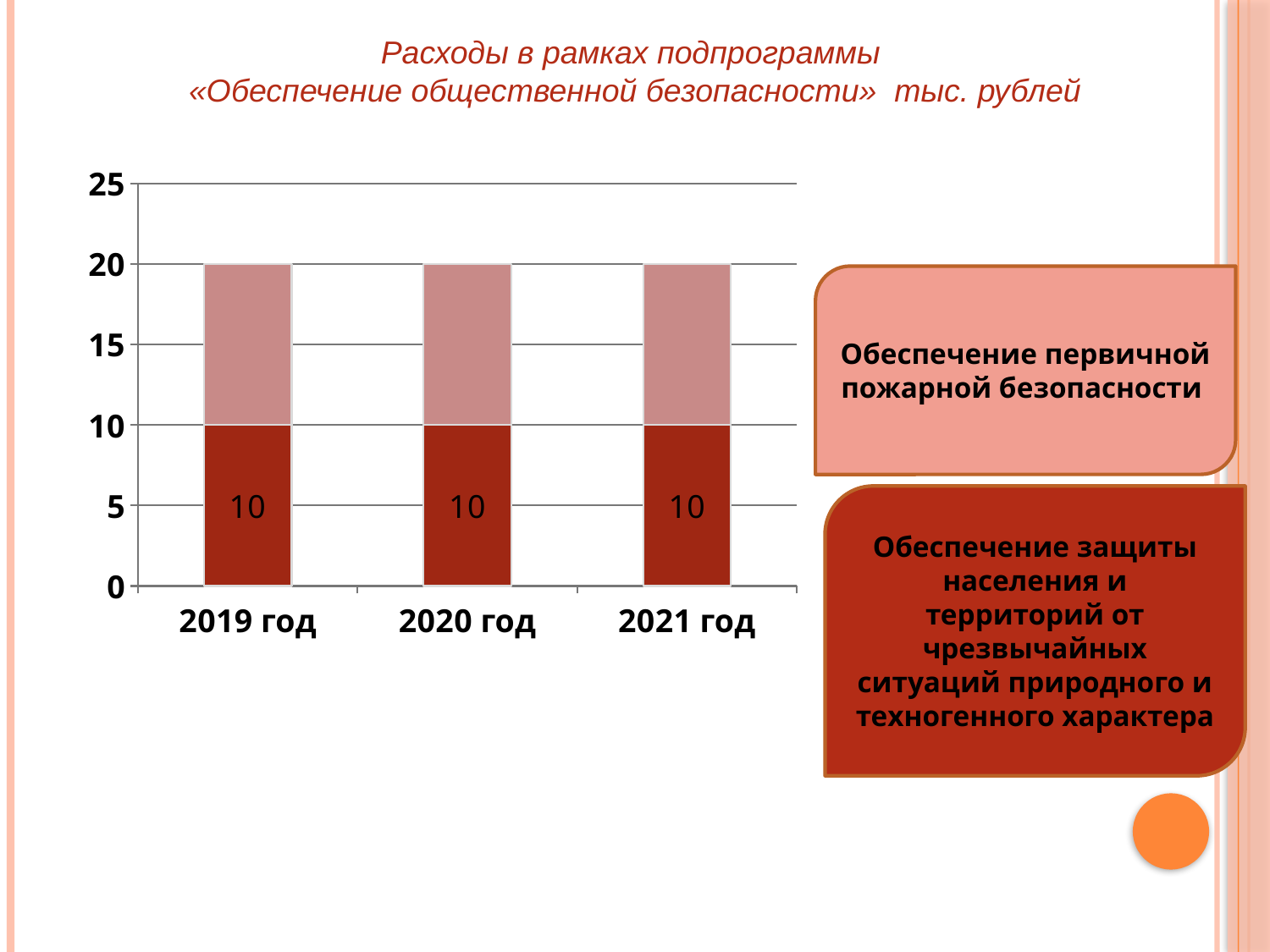
What is the value of the dark red segment for 2021 год? 10 What is the total height of the stacked bar for 2021 год? 20 Do the total expenses rise, fall or stay the same from 2019 год to 2021 год? Stay the same Which colour represents «Обеспечение первичной пожарной безопасности» in the chart? Light pink Is the total value of the bar for 2020 год greater or less than 15? greater What is the value of the dark red segment for 2020 год? 10 How many series (expense items) are identified by the coloured boxes next to the chart? 2 What is the total height of the stacked bar for 2019 год? 20 What is the value of the dark red segment (Обеспечение защиты населения и территорий от чрезвычайных ситуаций природного и техногенного характера) for 2019 год? 10 How many years (categories) are shown on the x axis of the chart? 3 What kind of chart is shown on the slide? Stacked bar chart What is the title of the chart? Расходы в рамках подпрограммы «Обеспечение общественной безопасности» тыс. рублей